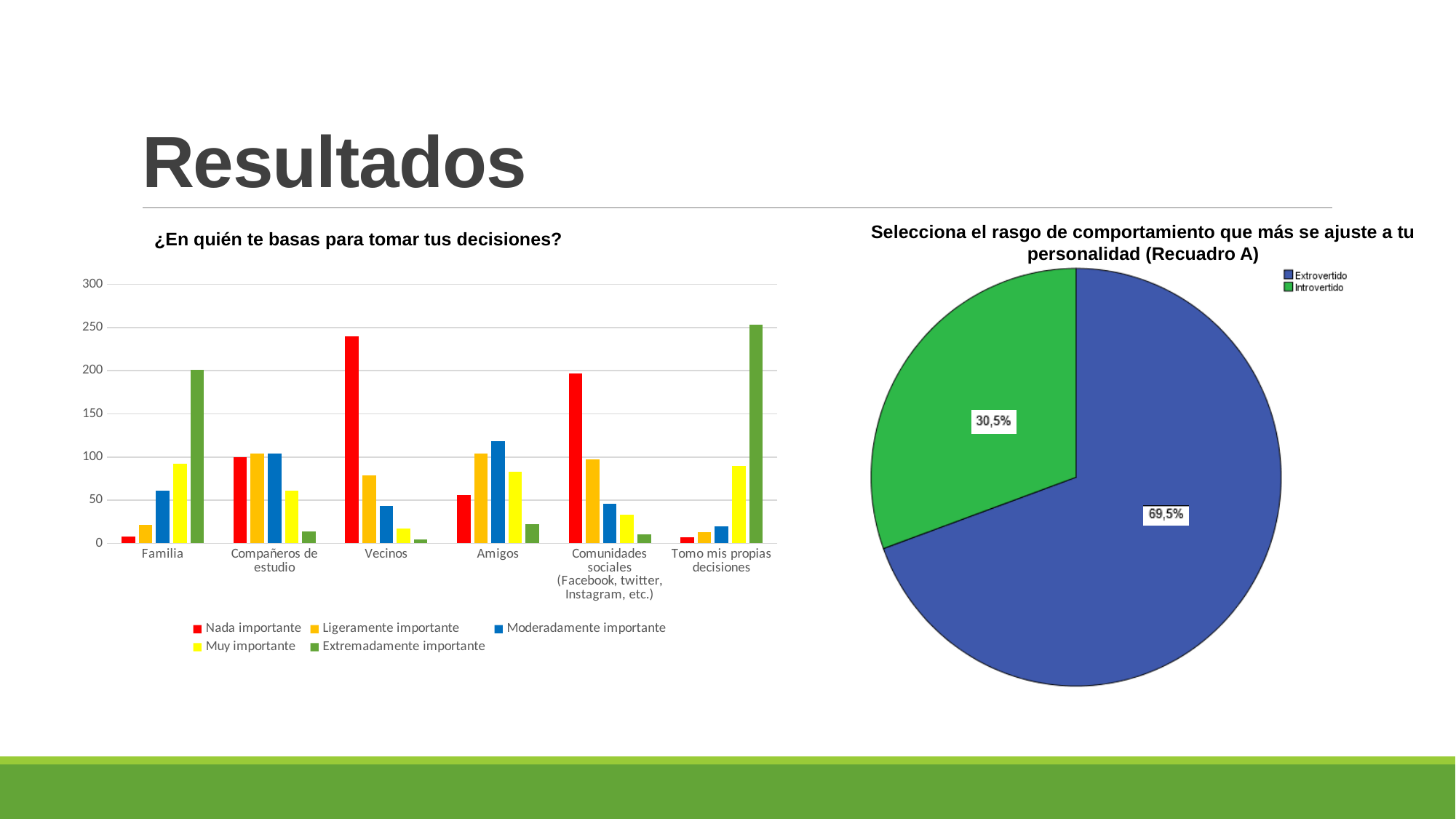
In the chart "¿En quién te basas para tomar tus decisiones?", how many series does the legend list? 5 In the pie chart "Selecciona el rasgo de comportamiento que más se ajuste a tu personalidad (Recuadro A)", what colour is the Introvertido slice? Green In the chart "¿En quién te basas para tomar tus decisiones?", which category has the highest "Nada importante" bar? Vecinos In the chart "¿En quién te basas para tomar tus decisiones?", which category has the highest "Extremadamente importante" bar? Tomo mis propias decisiones In the chart "¿En quién te basas para tomar tus decisiones?", is the "Nada importante" value for Vecinos greater or less than 200? greater In the chart "¿En quién te basas para tomar tus decisiones?", which is larger: the "Extremadamente importante" value for Familia or for Compañeros de estudio? Familia In the pie chart "Selecciona el rasgo de comportamiento que más se ajuste a tu personalidad (Recuadro A)", what share is Extrovertido? 69,5% In the pie chart "Selecciona el rasgo de comportamiento que más se ajuste a tu personalidad (Recuadro A)", what share is Introvertido? 30,5% In the chart "¿En quién te basas para tomar tus decisiones?", is the "Moderadamente importante" value for Amigos greater or less than 100? greater In the pie chart "Selecciona el rasgo de comportamiento que más se ajuste a tu personalidad (Recuadro A)", what is the difference between the Extrovertido and Introvertido shares? 39,0% In the chart "¿En quién te basas para tomar tus decisiones?", how many categories are shown on the x axis? 6 What kind of chart is the one titled "¿En quién te basas para tomar tus decisiones?"? Bar chart